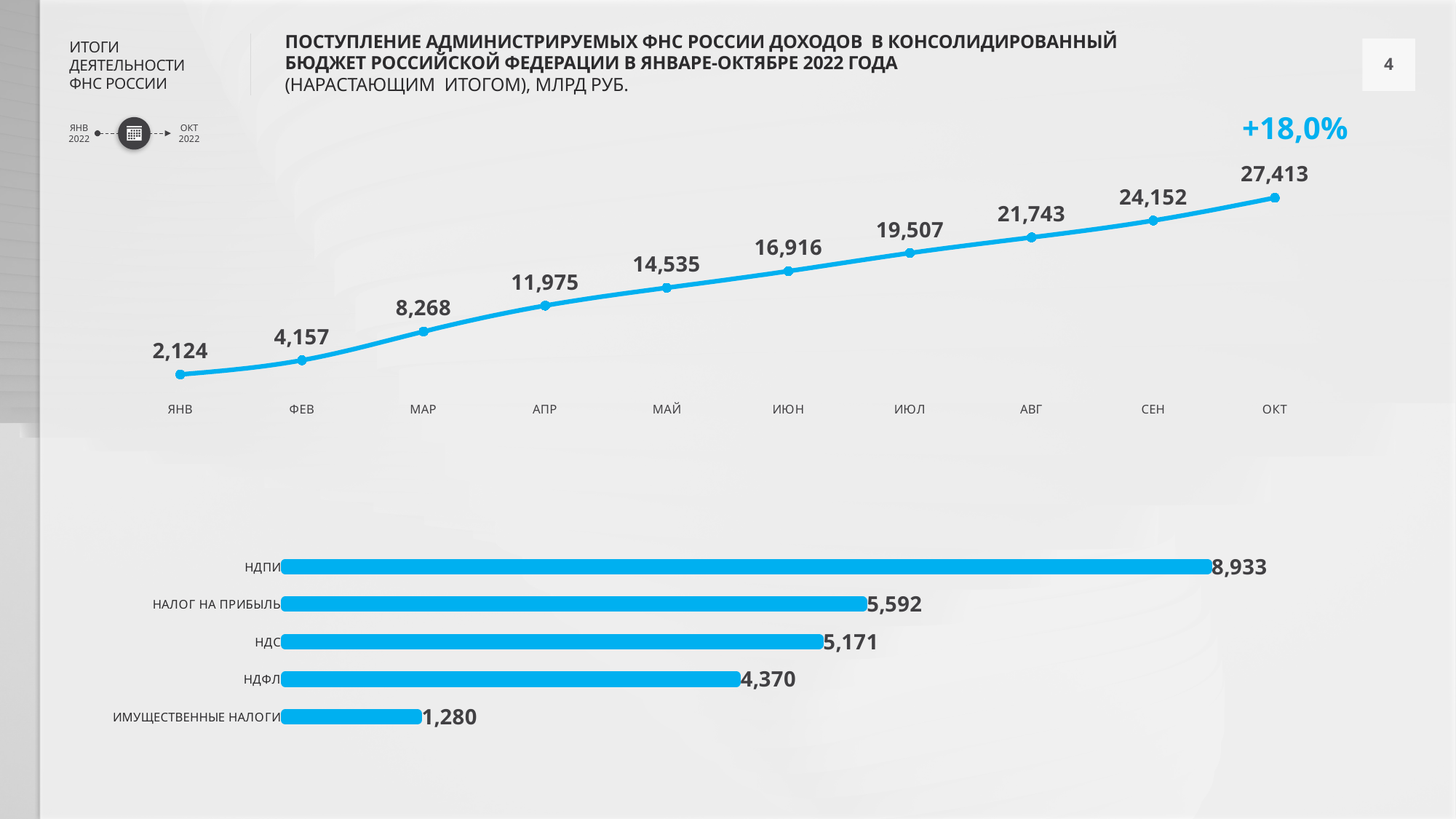
In the bottom bar chart, which category has the lowest value? ИМУЩЕСТВЕННЫЕ НАЛОГИ In the top line chart, what is the difference between the values for ОКТ and СЕН? 3,261 In the top line chart, what is the value for МАЙ? 14,535 What percentage growth figure is shown above the top line chart? +18,0% In the bottom bar chart, what is the value for НДФЛ? 4,370 In the top line chart, what is the value for ЯНВ? 2,124 What type of chart is the top chart on the slide? line chart In the top line chart, how many months are plotted? 10 In the top line chart, which month has the highest value? ОКТ In the bottom bar chart, which is larger: НАЛОГ НА ПРИБЫЛЬ or НДС? НАЛОГ НА ПРИБЫЛЬ In the bottom bar chart, what is the difference between НДПИ and НДС? 3,762 In the top line chart, do the values rise or fall from ЯНВ to ОКТ? rise